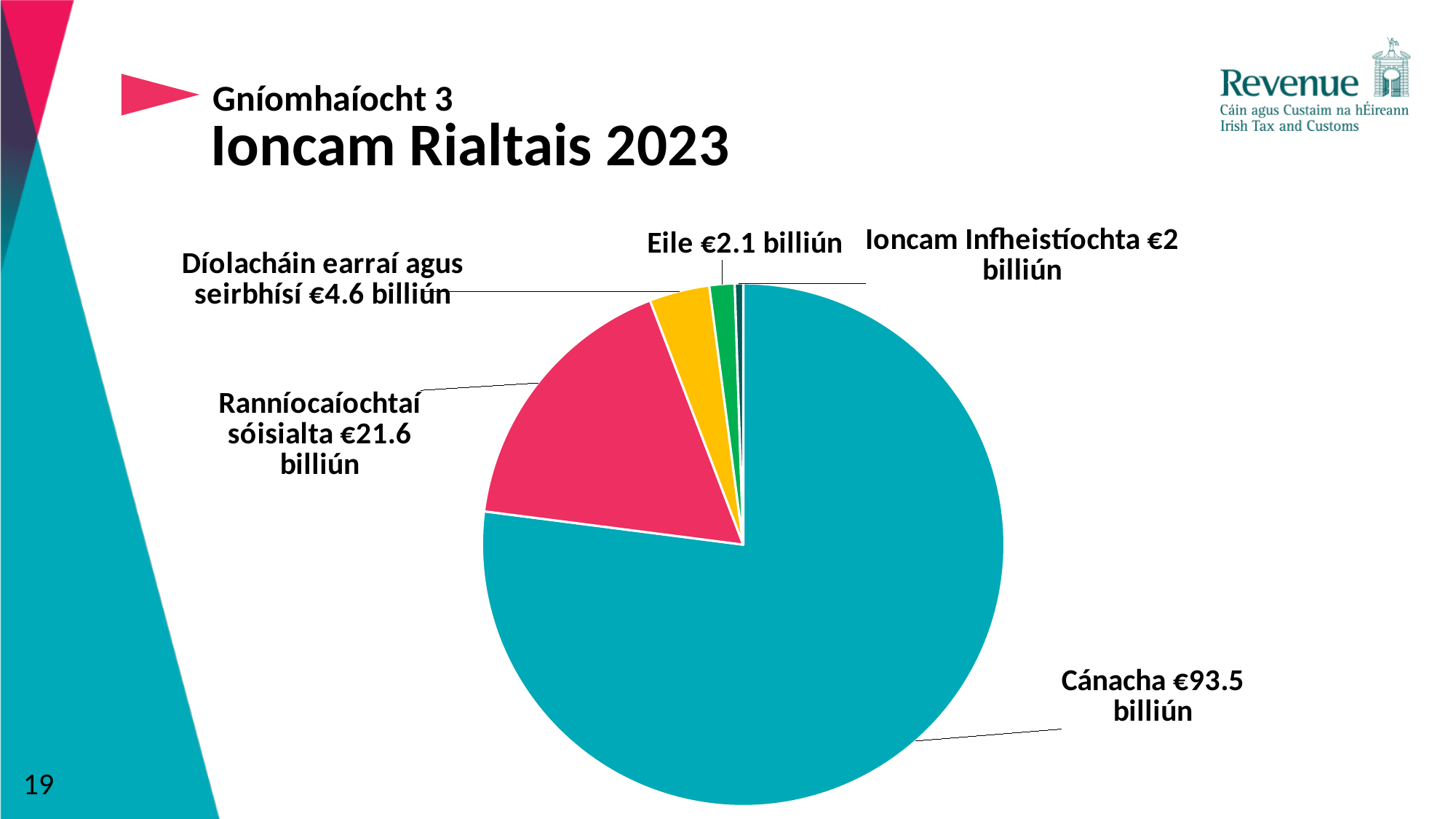
What is the value for Cánacha? €93.5 billiún What kind of chart is shown on the slide? pie chart How many slices does the pie chart have? 5 What is the value for Ioncam Infheistíochta? €2 billiún What is the value for Ranníocaíochtaí sóisialta? €21.6 billiún Which category has the smallest value? Ioncam Infheistíochta What is the value for Díolacháin earraí agus seirbhísí? €4.6 billiún What is the value for Eile? €2.1 billiún Which is larger, Díolacháin earraí agus seirbhísí or Eile? Díolacháin earraí agus seirbhísí What is the difference between Cánacha and Ranníocaíochtaí sóisialta? €71.9 billiún What is the title of the slide containing the chart? Ioncam Rialtais 2023 Which category has the largest slice of the pie? Cánacha